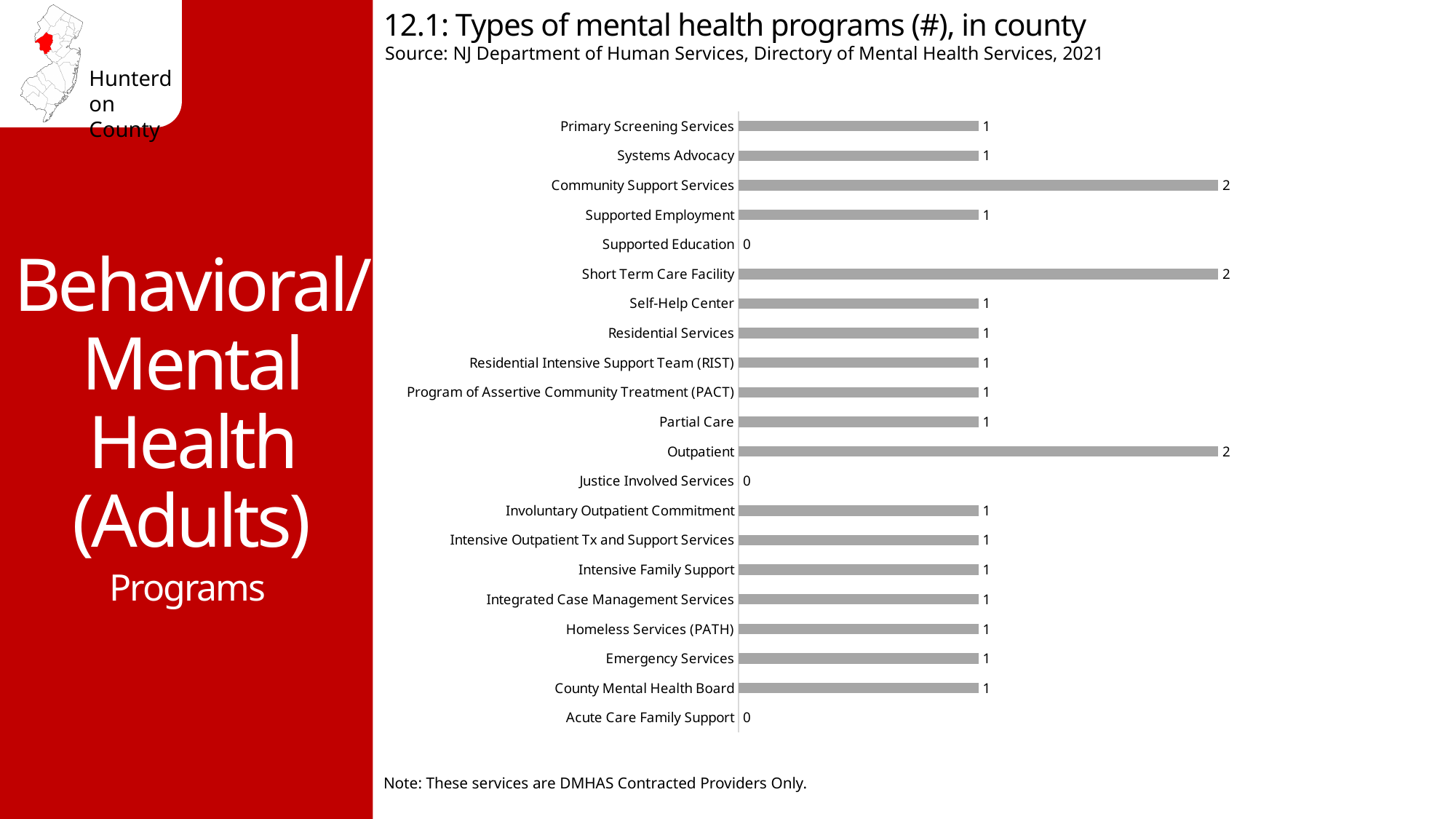
How many program types (categories) are shown in the chart? 21 How many program types have a value of 2? 3 Which is larger, the value for Short Term Care Facility or the value for Partial Care? Short Term Care Facility What is the value for Supported Education? 0 What is the difference between the value for Outpatient and the value for Acute Care Family Support? 2 What type of chart is shown on the slide? bar chart What is the value for Homeless Services (PATH)? 1 What is the highest value shown in the chart? 2 What is the value for Outpatient? 2 What is the value for Justice Involved Services? 0 What is the title of the chart? 12.1: Types of mental health programs (#), in county What is the value for Community Support Services? 2